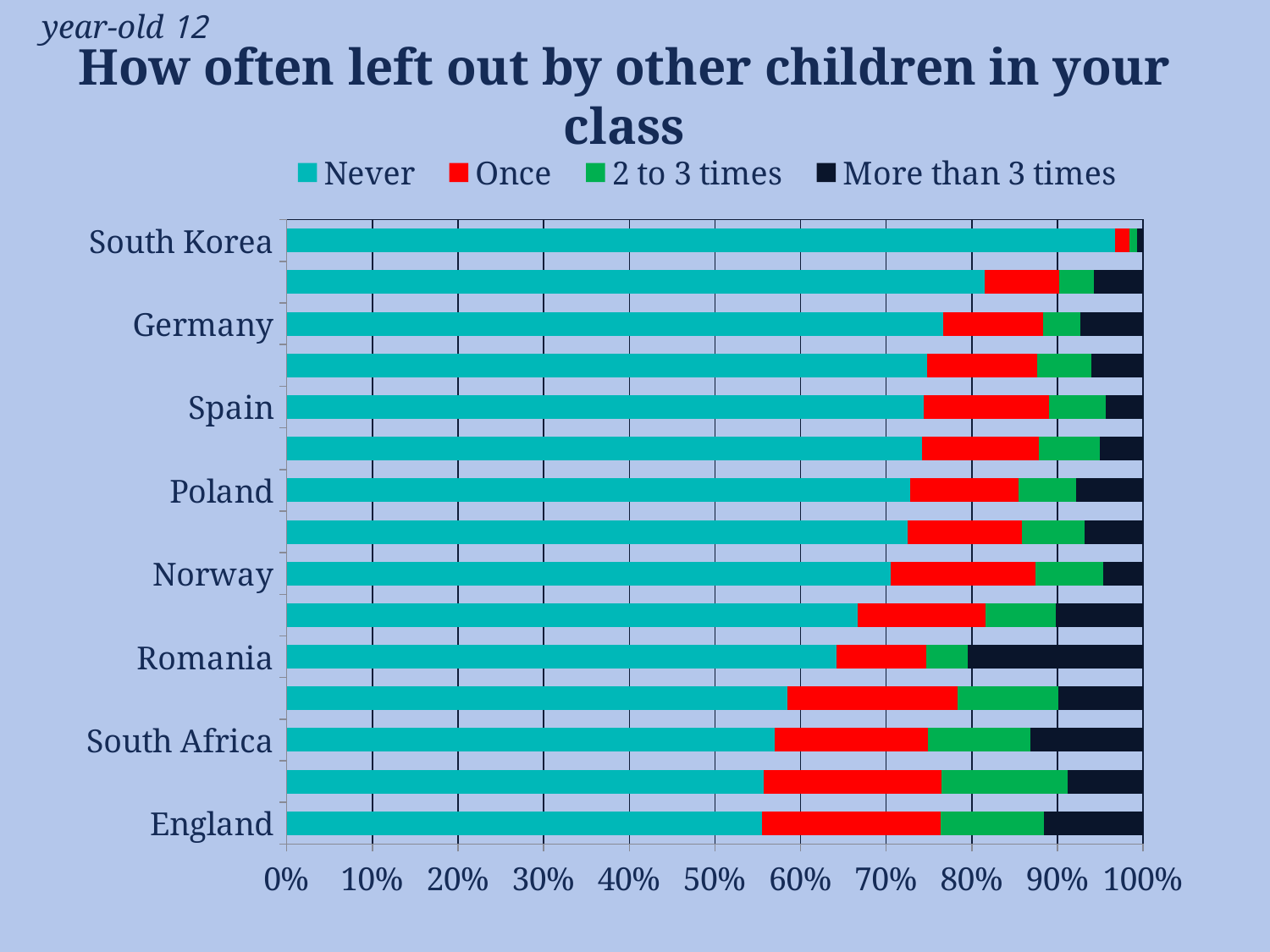
What is the title of the chart? How often left out by other children in your class Is the 'Never' share for Germany greater or less than 70%? greater Which labelled country has the largest 'Never' share? South Korea Is the 'Never' share for Romania greater or less than 60%? greater Which has the larger 'Never' share, South Korea or England? South Korea Which has the larger 'Never' share, Germany or Romania? Germany How many series does the legend list? 4 How many bars are plotted in the chart? 15 What kind of chart is shown on the slide? Stacked bar chart Is the 'Never' share for South Korea greater or less than 90%? greater Which legend entry is shown in red? Once